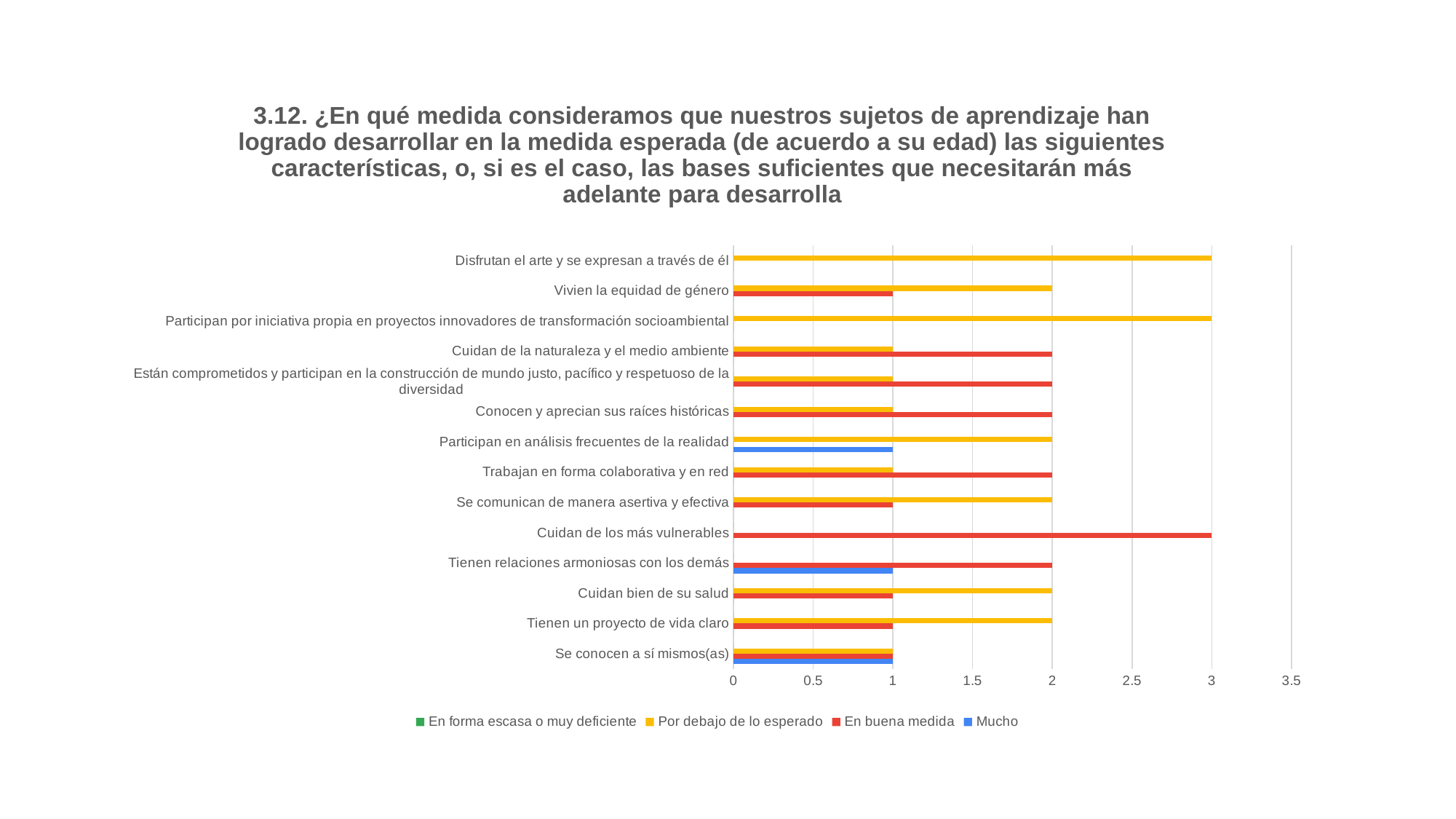
What is the total of all series for 'Se conocen a sí mismos(as)'? 3 How many series does the legend list? 4 What is the value of 'En buena medida' for 'Cuidan de los más vulnerables'? 3 Which category has the highest value for 'En buena medida'? Cuidan de los más vulnerables What is the difference between 'En buena medida' and 'Por debajo de lo esperado' for 'Trabajan en forma colaborativa y en red'? 1 What is the value of 'Mucho' for 'Participan en análisis frecuentes de la realidad'? 1 What is the value of 'Por debajo de lo esperado' for 'Disfrutan el arte y se expresan a través de él'? 3 For 'Vivien la equidad de género', which is larger: 'Por debajo de lo esperado' or 'En buena medida'? Por debajo de lo esperado What is the value of 'En buena medida' for 'Cuidan de la naturaleza y el medio ambiente'? 2 How many categories are plotted on the chart? 14 What kind of chart is shown on the slide? bar chart Which series in the legend is shown in blue? Mucho